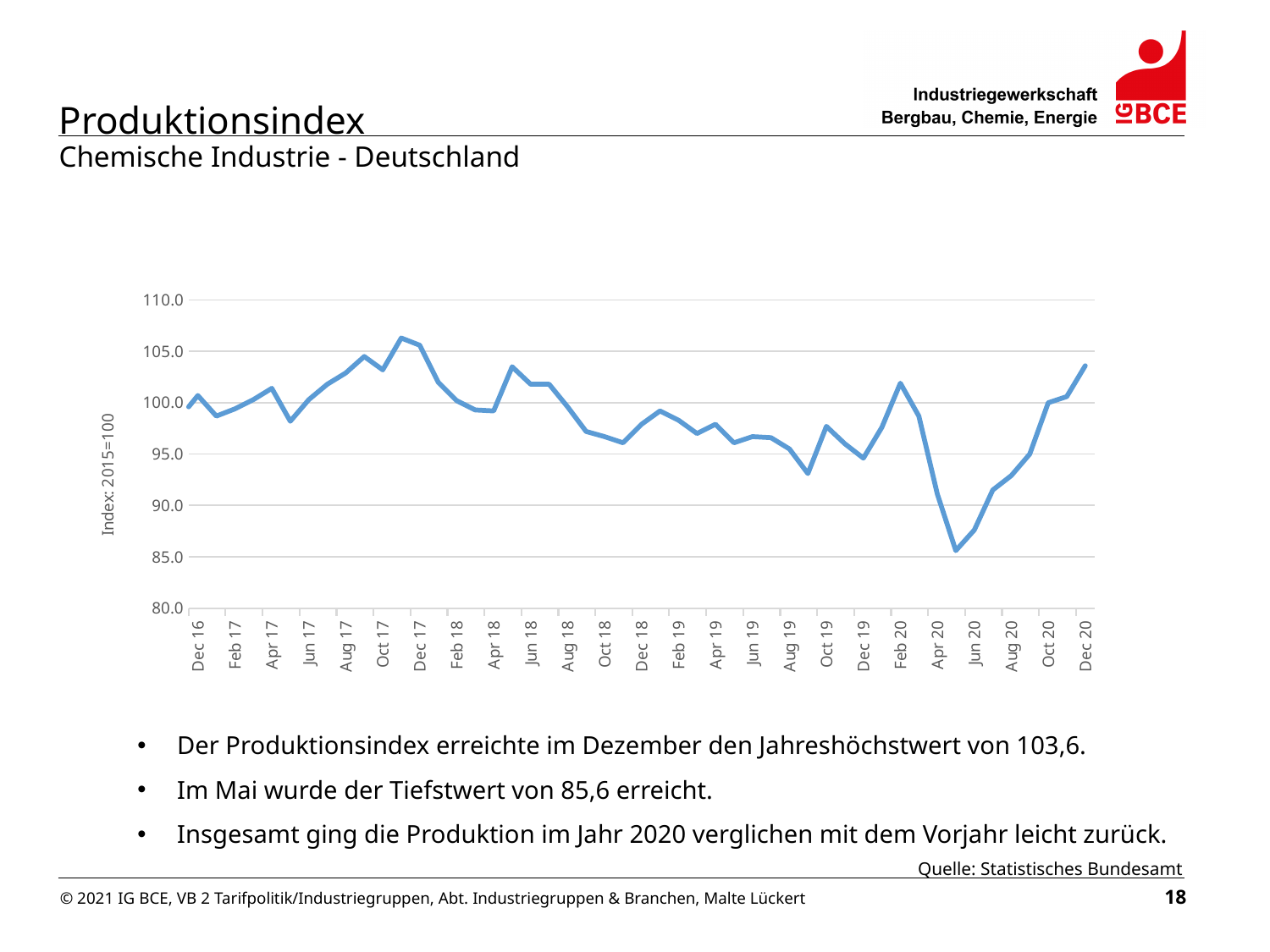
According to the slide, what value did the production index reach in December 2020? 103,6 What kind of chart is shown on the slide? line chart Is the value for Jun 20 greater or less than 90.0? less How many month labels are shown on the x axis? 25 Does the line rise or fall between Jun 20 and Dec 20? rise Is the value for Dec 16 greater or less than 95.0? greater Is the value for Dec 17 greater or less than 100.0? greater Does the line rise or fall between Feb 20 and May 20? fall What is the label of the y axis? Index: 2015=100 According to the slide, what was the lowest value of the production index in 2020, reached in May? 85,6 In which month of 2020 does the line reach its lowest point? May 2020